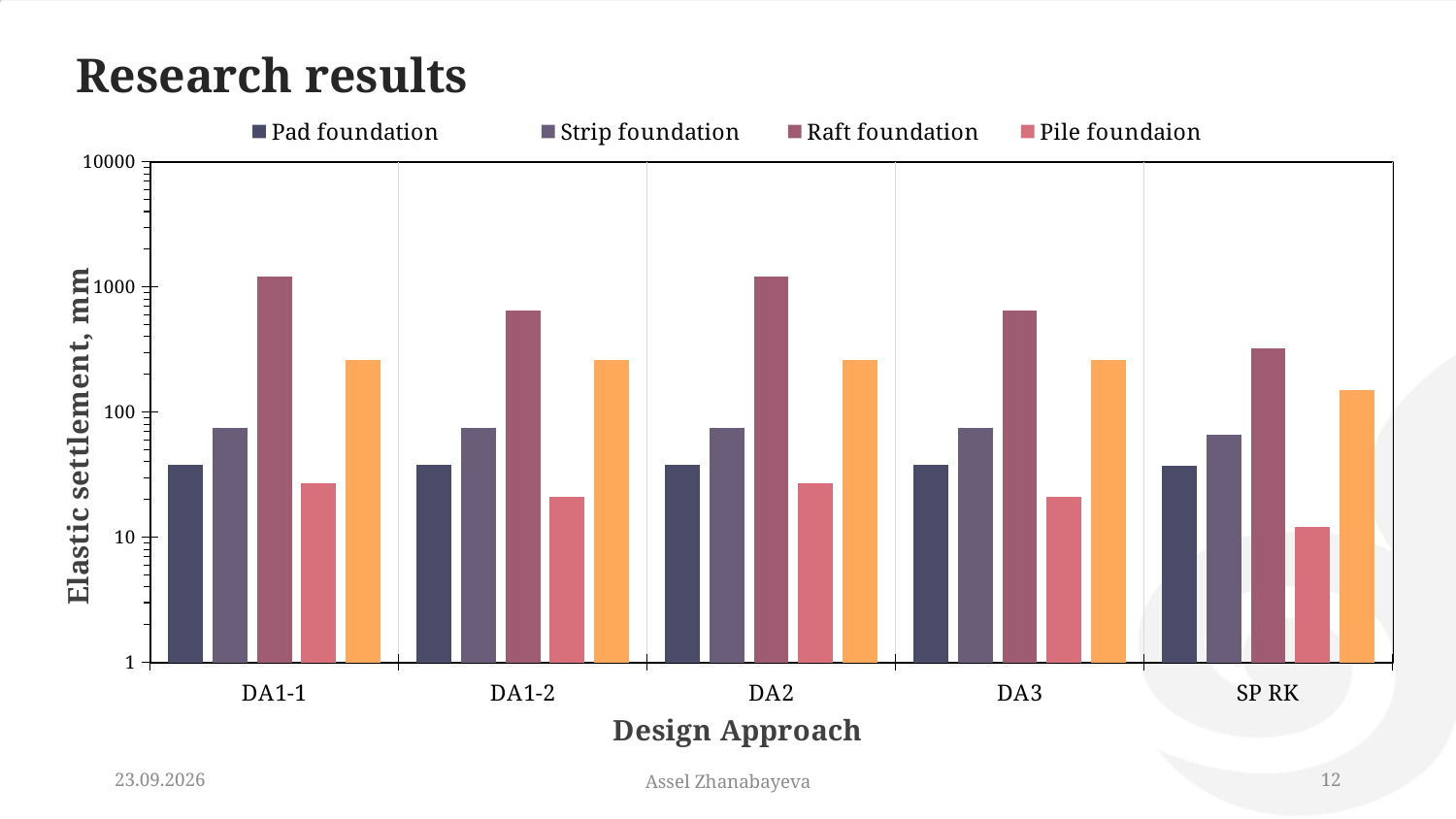
Is the Raft foundation value for DA1-1 greater or less than 1000? greater What is the label of the y axis? Elastic settlement, mm How many series does the legend list? 4 What kind of chart is shown on the slide? bar chart What is the label of the x axis? Design Approach Which is larger, the Raft foundation value for DA1-1 or the Raft foundation value for SP RK? DA1-1 Is the Pile foundaion value for SP RK greater or less than 10? greater Which foundation type has the lowest elastic settlement in the DA3 group? Pile foundaion How many design approach categories are shown on the x axis? 5 Is the Pad foundation value for DA2 greater or less than 100? less Which design approach has the lowest Raft foundation value? SP RK Which foundation type has the highest elastic settlement in the DA1-1 group? Raft foundation